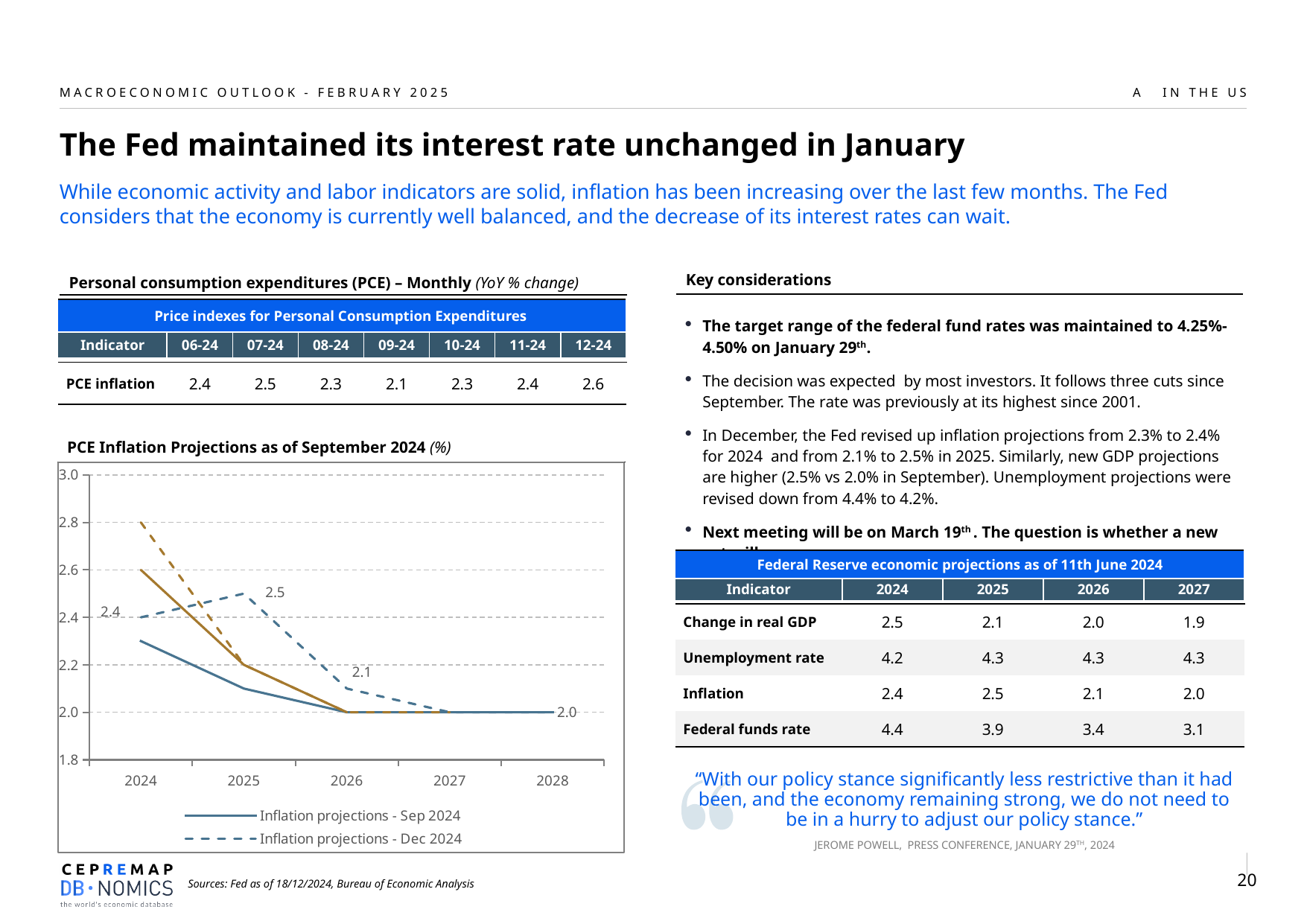
How many years are shown on the x axis of the PCE Inflation Projections chart? 5 In the PCE Inflation Projections chart, what is the difference between the labelled Dec 2024 projections for 2025 and 2026? 0.4 In the PCE Inflation Projections chart, what is the labelled value of the Inflation projections - Dec 2024 line for 2025? 2.5 What are the lowest and highest values shown on the y axis of the PCE Inflation Projections chart? 1.8 and 3.0 In the PCE Inflation Projections chart, what is the labelled value of the Inflation projections - Dec 2024 line for 2026? 2.1 In the PCE Inflation Projections chart, what is the labelled value of the Inflation projections - Dec 2024 line for 2024? 2.4 What kind of chart is "PCE Inflation Projections as of September 2024"? line chart In the PCE Inflation Projections chart, is the value of the Inflation projections - Dec 2024 line for 2027 greater or less than 2.2? less How many series does the legend of the PCE Inflation Projections chart list? 2 In the PCE Inflation Projections chart, do the Inflation projections - Dec 2024 values rise or fall from 2025 to 2028? fall In the PCE Inflation Projections chart, is the labelled Dec 2024 projection larger for 2025 or for 2026? 2025 In the PCE Inflation Projections chart, which year has the highest labelled value on the Inflation projections - Dec 2024 line? 2025